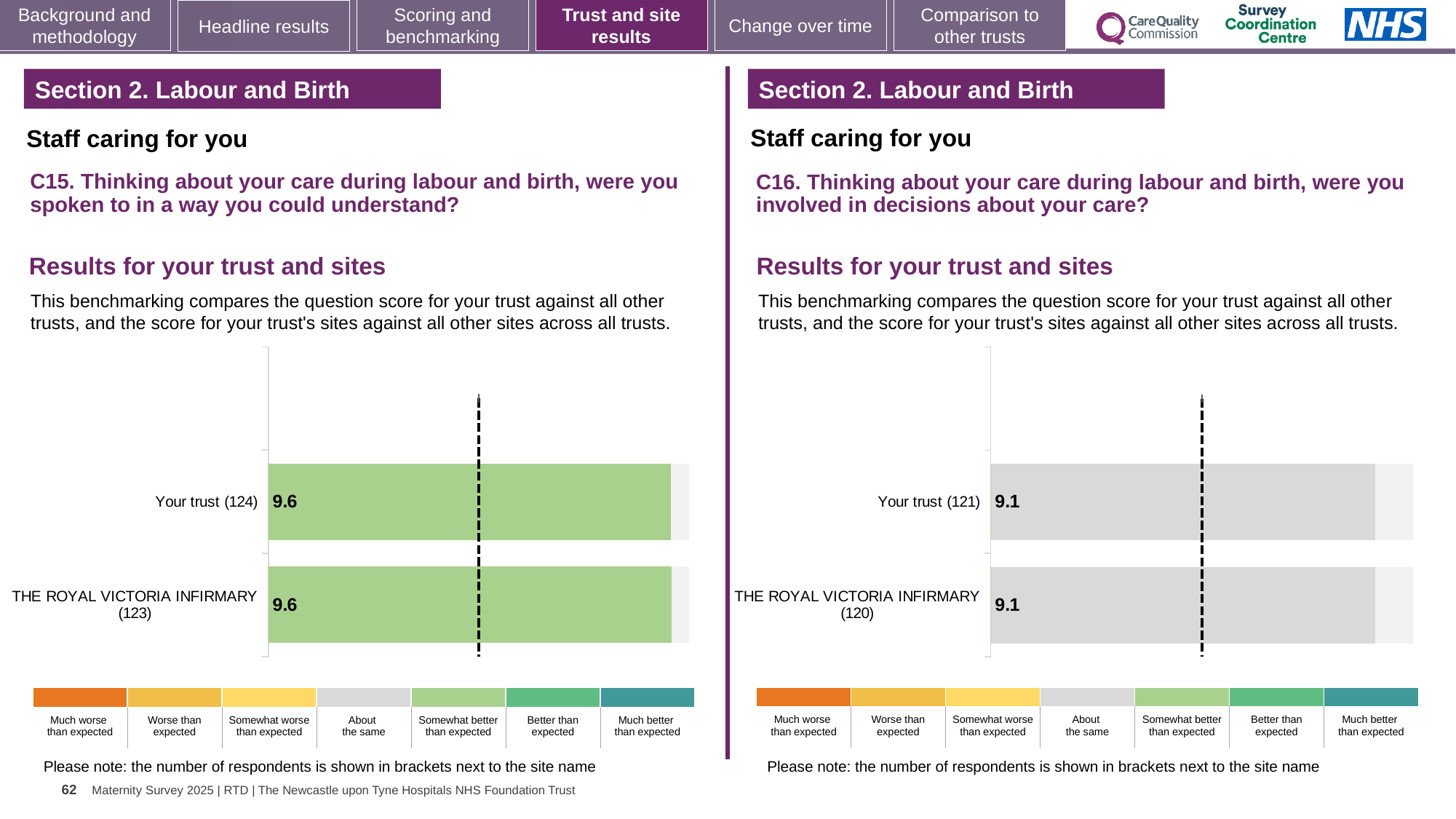
In the C15 chart on the left, what is the score for Your trust? 9.6 According to the colour key, which benchmark category do the grey bars in the C16 chart on the right represent? About the same In the C16 chart on the right, what is the difference between the score for Your trust and the score for THE ROYAL VICTORIA INFIRMARY? 0 In the C16 chart on the right, what is the score for Your trust? 9.1 In the C15 chart on the left, what is the score for THE ROYAL VICTORIA INFIRMARY? 9.6 How many bars are plotted in the C15 chart on the left? 2 In the C16 chart on the right, how many respondents are shown in brackets for THE ROYAL VICTORIA INFIRMARY? 120 In the C15 chart on the left, what is the difference between the score for Your trust and the score for THE ROYAL VICTORIA INFIRMARY? 0 How many bars are plotted in the C16 chart on the right? 2 In the C15 chart on the left, how many respondents are shown in brackets for Your trust? 124 In the C16 chart on the right, what is the score for THE ROYAL VICTORIA INFIRMARY? 9.1 What type of chart is used for the C15 results on the left? Bar chart